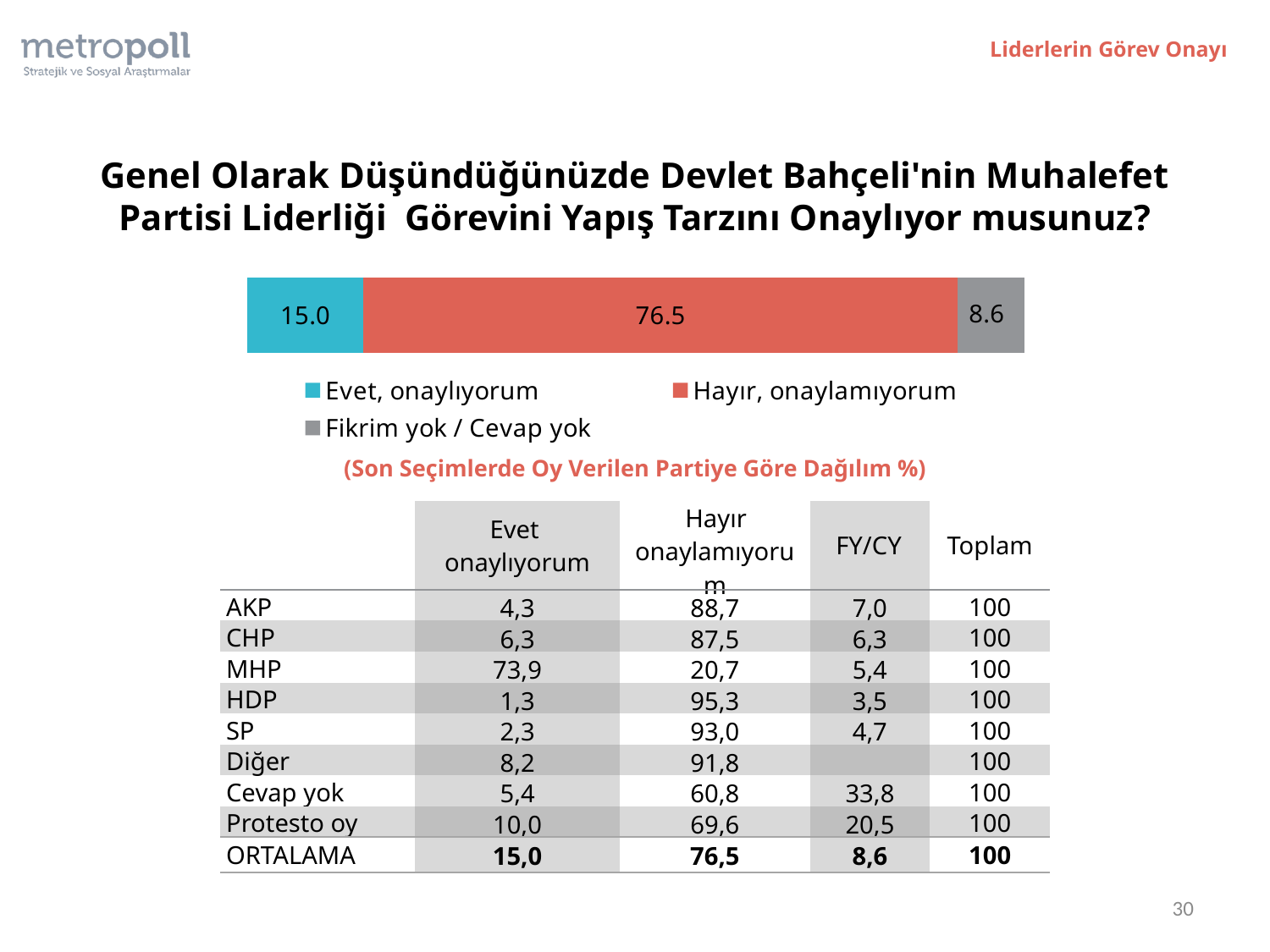
What value is shown for the "Hayır, onaylamıyorum" segment of the bar? 76.5 What kind of chart is shown on the slide? Stacked bar chart What value is shown for the "Fikrim yok / Cevap yok" segment of the bar? 8.6 How many series does the chart legend list? 3 What is the difference between the "Hayır, onaylamıyorum" and "Evet, onaylıyorum" values in the bar? 61.5 Which segment of the bar has the largest value? Hayır, onaylamıyorum What colour is the "Evet, onaylıyorum" segment of the bar? Teal (blue-green) What colour is the "Hayır, onaylamıyorum" segment of the bar? Red Which is larger in the bar: "Evet, onaylıyorum" or "Fikrim yok / Cevap yok"? Evet, onaylıyorum What is the total of the three segments in the stacked bar? 100.1 Which segment of the bar has the smallest value? Fikrim yok / Cevap yok What value is shown for the "Evet, onaylıyorum" segment of the bar? 15.0